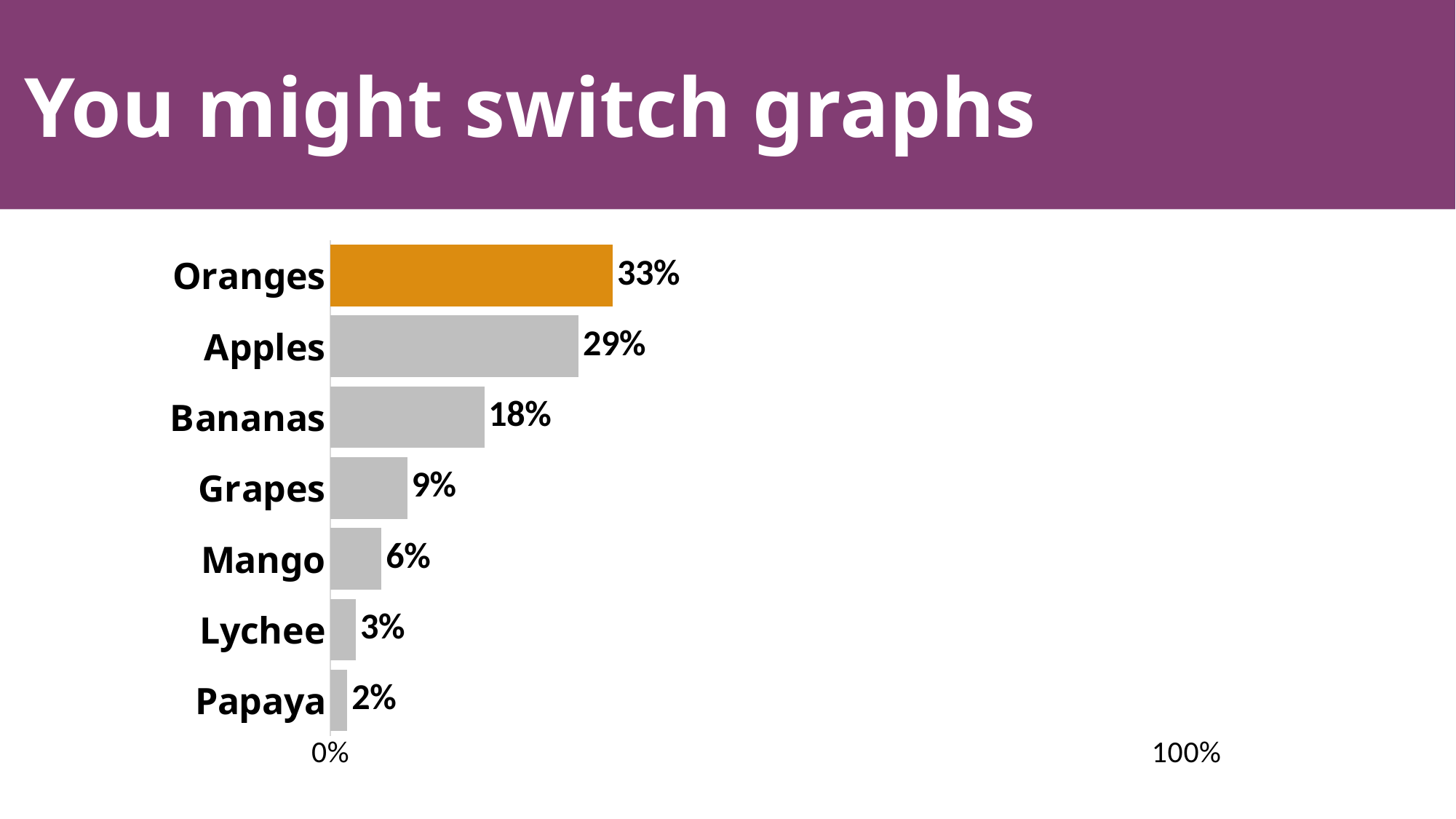
Which bar is coloured orange rather than grey? Oranges What is the value for Bananas? 18% What is the title of the slide? You might switch graphs What is the value for Lychee? 3% Which category has the lowest value? Papaya Which is larger, the value for Mango or the value for Grapes? Grapes What is the value for Oranges? 33% What is the difference between the values for Oranges and Apples? 4% Which category has the highest value? Oranges What is the difference between the values for Bananas and Grapes? 9% How many categories are shown in the chart? 7 What kind of chart is shown on the slide? Bar chart